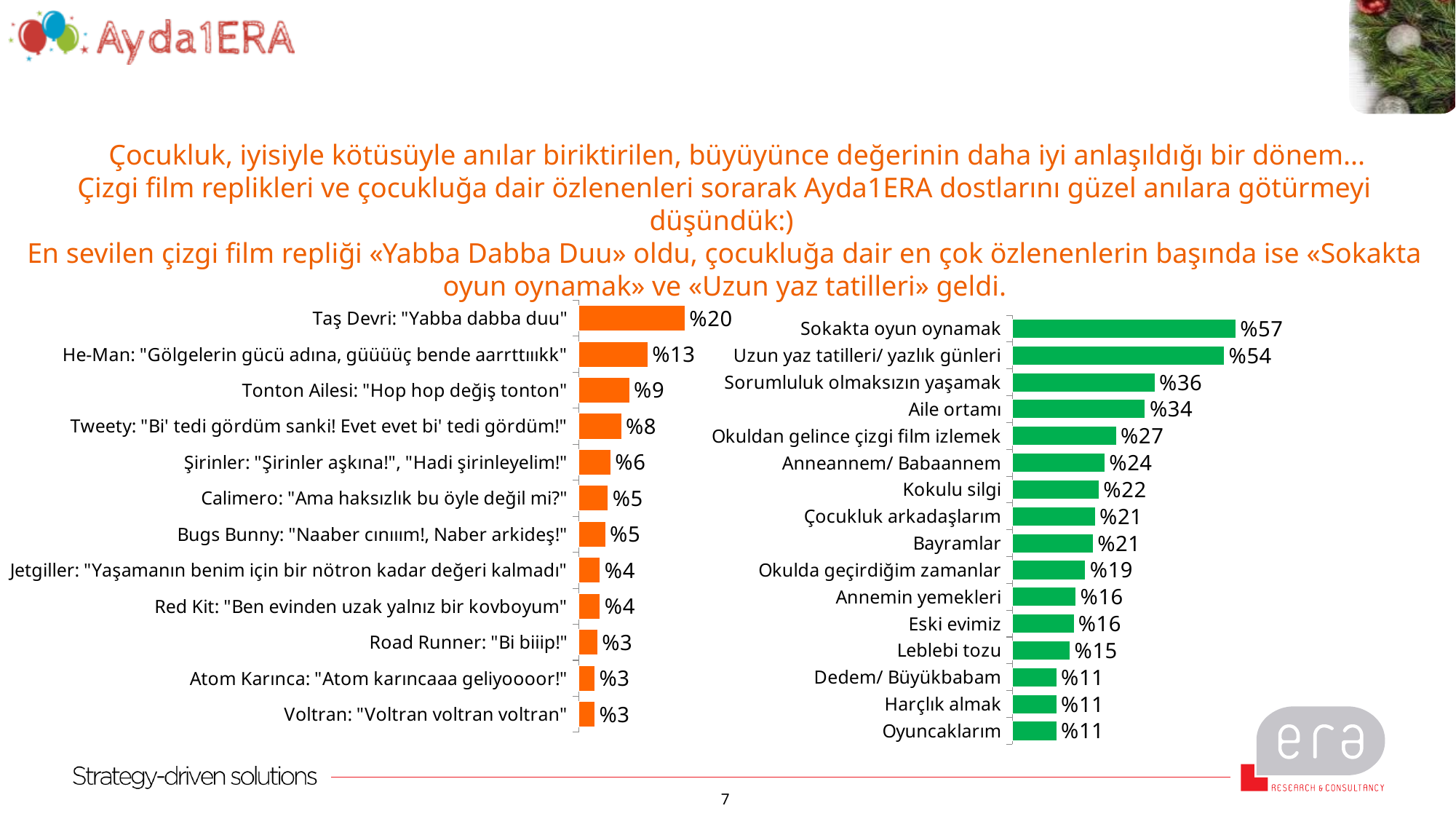
In the left (orange) chart, which category has the highest value? Taş Devri: "Yabba dabba duu" In the left (orange) chart, what is the value for Tonton Ailesi: "Hop hop değiş tonton"? %9 How many categories are shown in the right (green) chart? 16 What type of chart is the left (orange) chart? Bar chart How many categories are shown in the left (orange) chart? 12 What colour are the bars in the right chart? Green In the left (orange) chart, what is the value for Taş Devri: "Yabba dabba duu"? %20 In the right (green) chart, what is the value for Kokulu silgi? %22 In the right (green) chart, which category has the highest value? Sokakta oyun oynamak In the left (orange) chart, what is the difference between Taş Devri: "Yabba dabba duu" and He-Man: "Gölgelerin gücü adına, güüüüç bende aarrttıııkk"? 7 percentage points In the right (green) chart, which is larger: Aile ortamı or Okuldan gelince çizgi film izlemek? Aile ortamı In the right (green) chart, what is the difference between Sokakta oyun oynamak and Uzun yaz tatilleri/ yazlık günleri? 3 percentage points